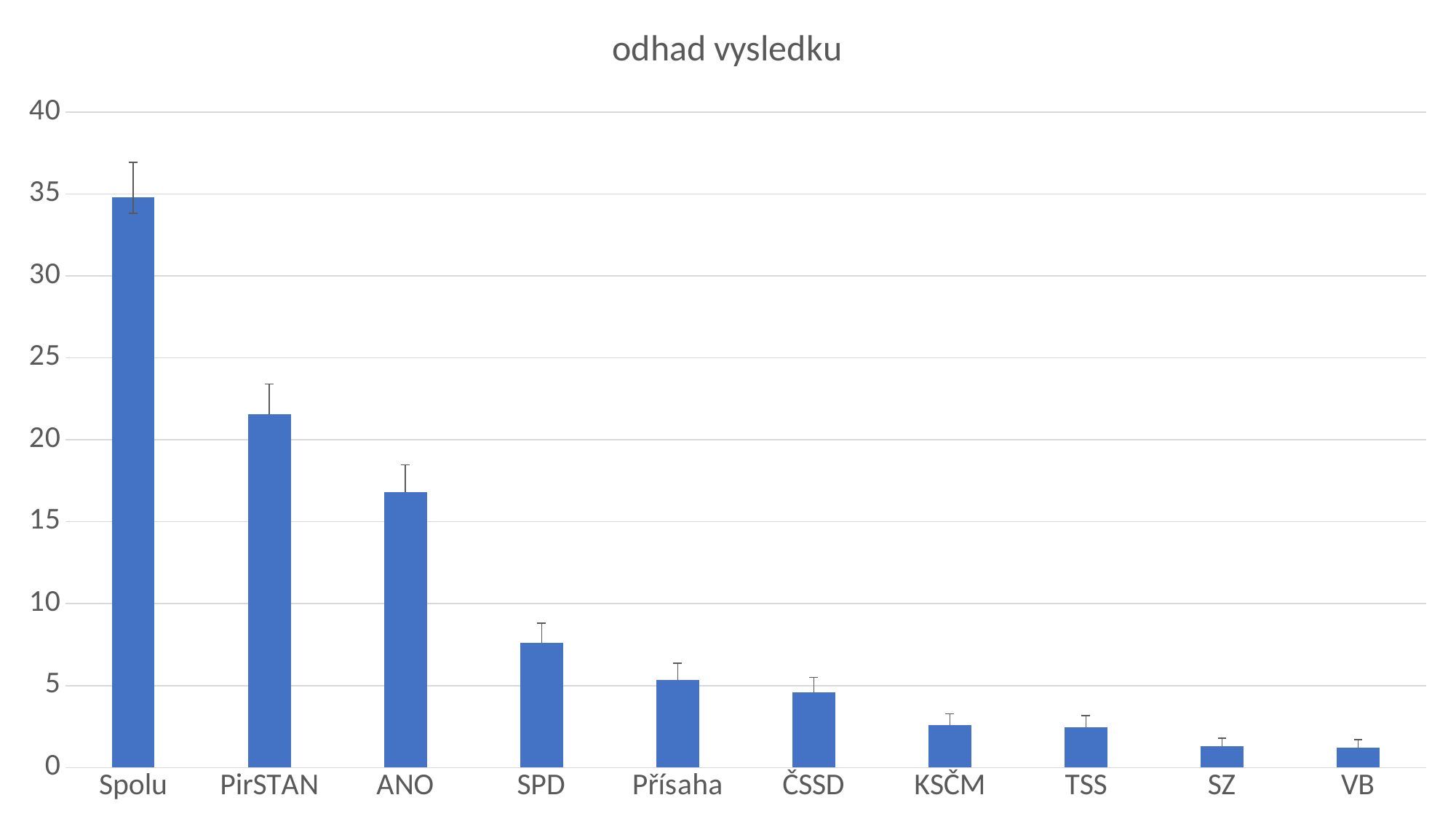
Do the values rise or fall from left to right along the x axis? fall What kind of chart is shown on the slide? bar chart Is the value for PirSTAN greater or less than 25? less Which is larger, the value for SPD or the value for ČSSD? SPD How many categories are shown on the x axis? 10 Is the value for ANO greater or less than 15? greater Is the value for SPD greater or less than 10? less Which is larger, the value for PirSTAN or the value for ANO? PirSTAN What is the title of the chart? odhad vysledku Which category has the highest value? Spolu